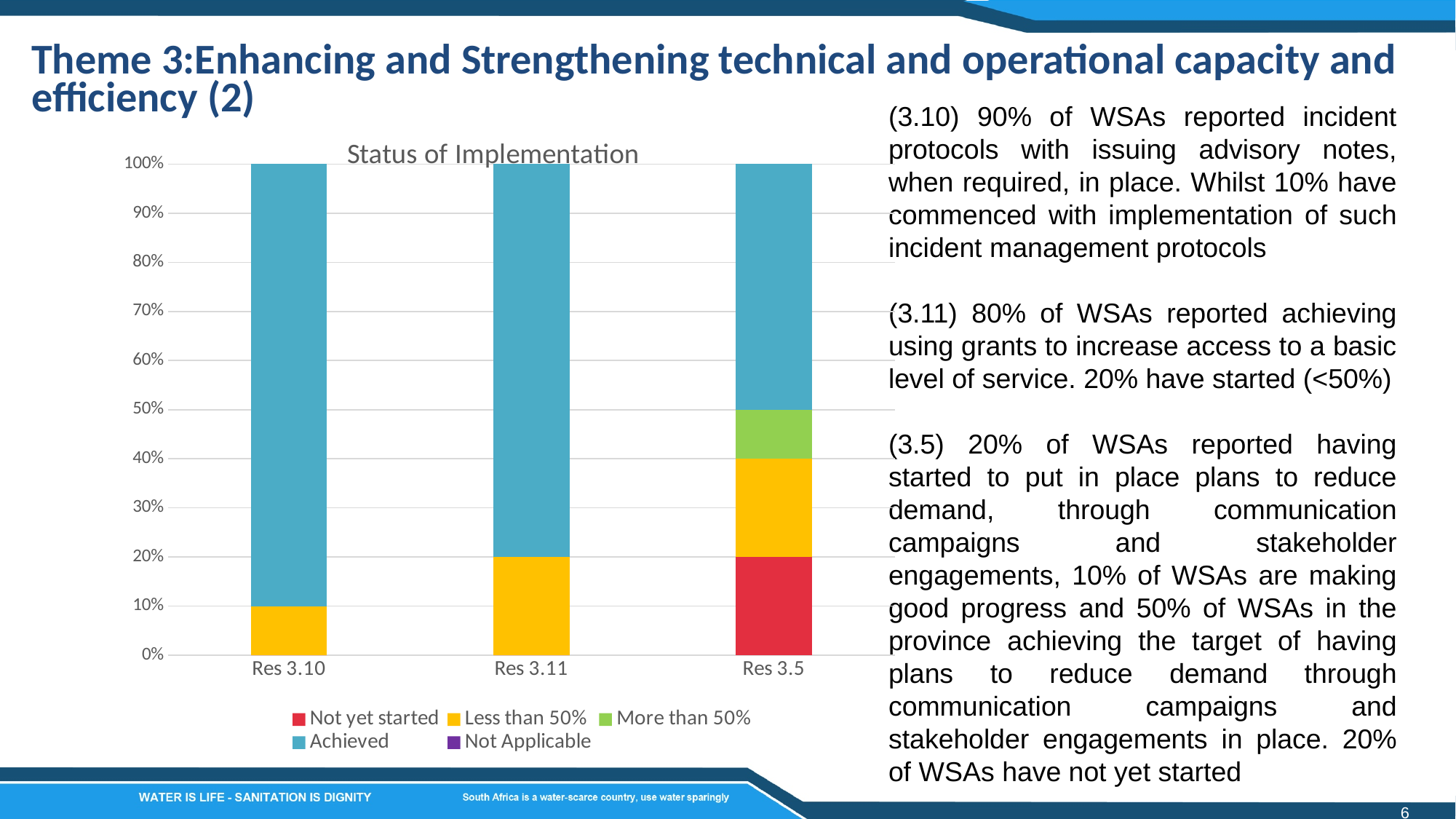
What is the 'Not yet started' value for Res 3.5? 20% How many series does the chart legend list? 5 Is the 'Achieved' value for Res 3.11 greater or less than 70%? greater Which category has the lowest 'Achieved' share? Res 3.5 What is the 'Achieved' value for Res 3.5? 50% Which category has the highest 'Achieved' share? Res 3.10 What is the title of the chart? Status of Implementation What is the total of the stacked bar for Res 3.5? 100% What is the 'Less than 50%' value for Res 3.10? 10% What type of chart is shown on the slide? Stacked bar chart How many categories are shown on the x axis of the chart? 3 What is the 'Less than 50%' value for Res 3.11? 20%